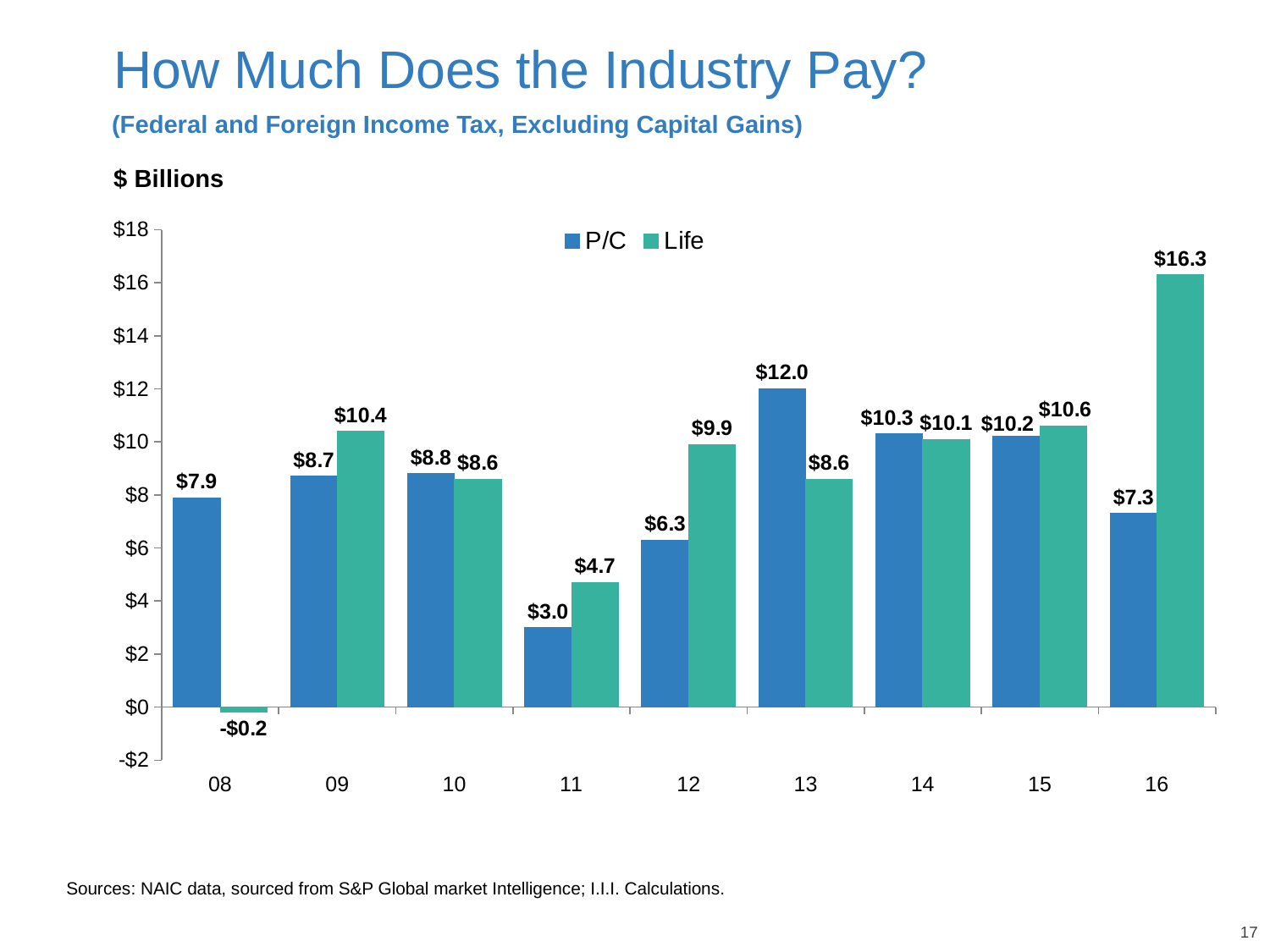
Which year has the lowest Life value? 08 What kind of chart is shown on the slide? bar chart Which is larger for 12, the P/C value or the Life value? Life What is the difference between the Life and P/C values for 16? $9.0 What is the Life value for 16? $16.3 What is the Life value for 08? -$0.2 How many years are shown on the x axis? 9 What unit is stated above the chart? $ Billions Which year has the highest P/C value? 13 What is the P/C value for 13? $12.0 Is the P/C value for 11 greater or less than $4? less How many series does the legend list? 2